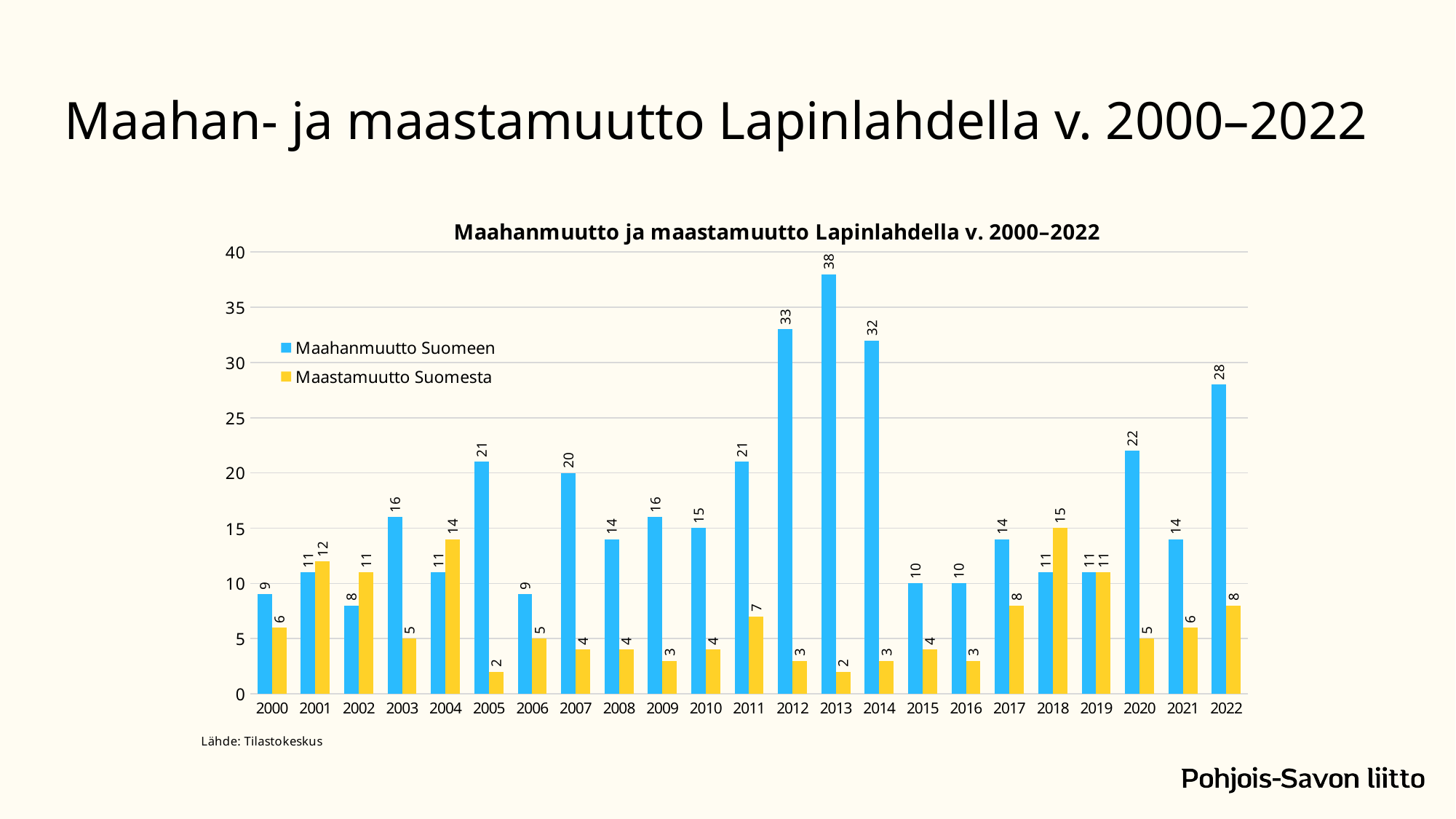
Which is larger in 2004, Maahanmuutto Suomeen or Maastamuutto Suomesta? Maastamuutto Suomesta In which year is Maastamuutto Suomesta highest? 2018 How many years are shown on the x axis? 23 How many series does the legend list? 2 What is the source cited below the chart? Tilastokeskus What is the value of Maahanmuutto Suomeen in 2022? 28 In which year is Maahanmuutto Suomeen lowest? 2002 What kind of chart is shown on the slide? Bar chart In which year is Maahanmuutto Suomeen highest? 2013 What is the difference between Maahanmuutto Suomeen and Maastamuutto Suomesta in 2012? 30 What is the value of Maastamuutto Suomesta in 2018? 15 What is the value of Maahanmuutto Suomeen in 2013? 38